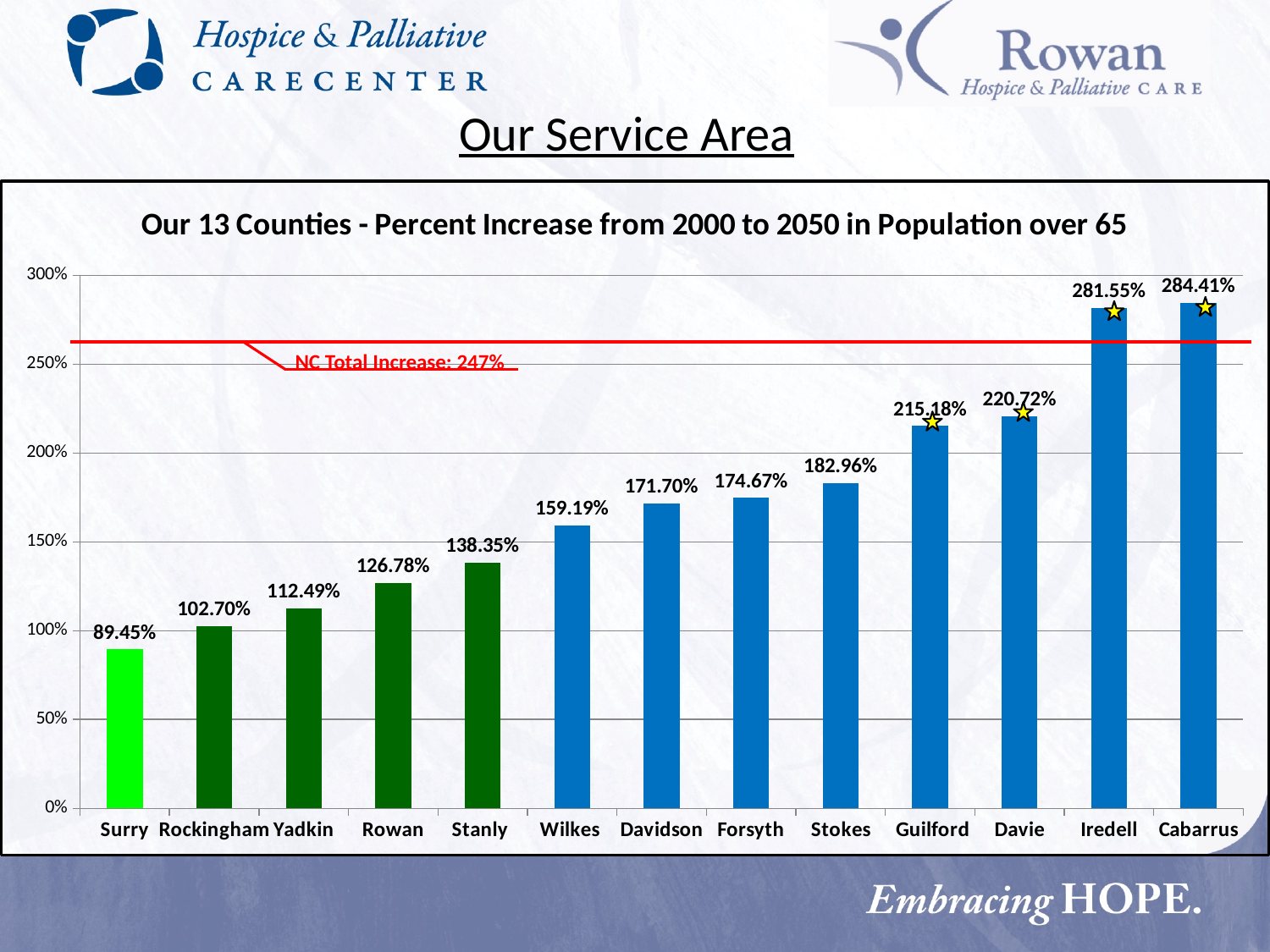
What is the NC total increase indicated by the red line? 247% What is the percent increase shown for Rowan? 126.78% Which county has the highest percent increase? Cabarrus Do the values rise or fall from left to right along the x axis? Rise What is the difference between the values for Cabarrus and Iredell? 2.86% Is the value for Wilkes greater or less than 150%? greater Which is larger, the value for Stokes or the value for Forsyth? Stokes Which county has the lowest percent increase? Surry What kind of chart is this? Bar chart How many counties are shown on the chart? 13 What is the percent increase shown for Guilford? 215.18% What is the title of the chart? Our 13 Counties - Percent Increase from 2000 to 2050 in Population over 65